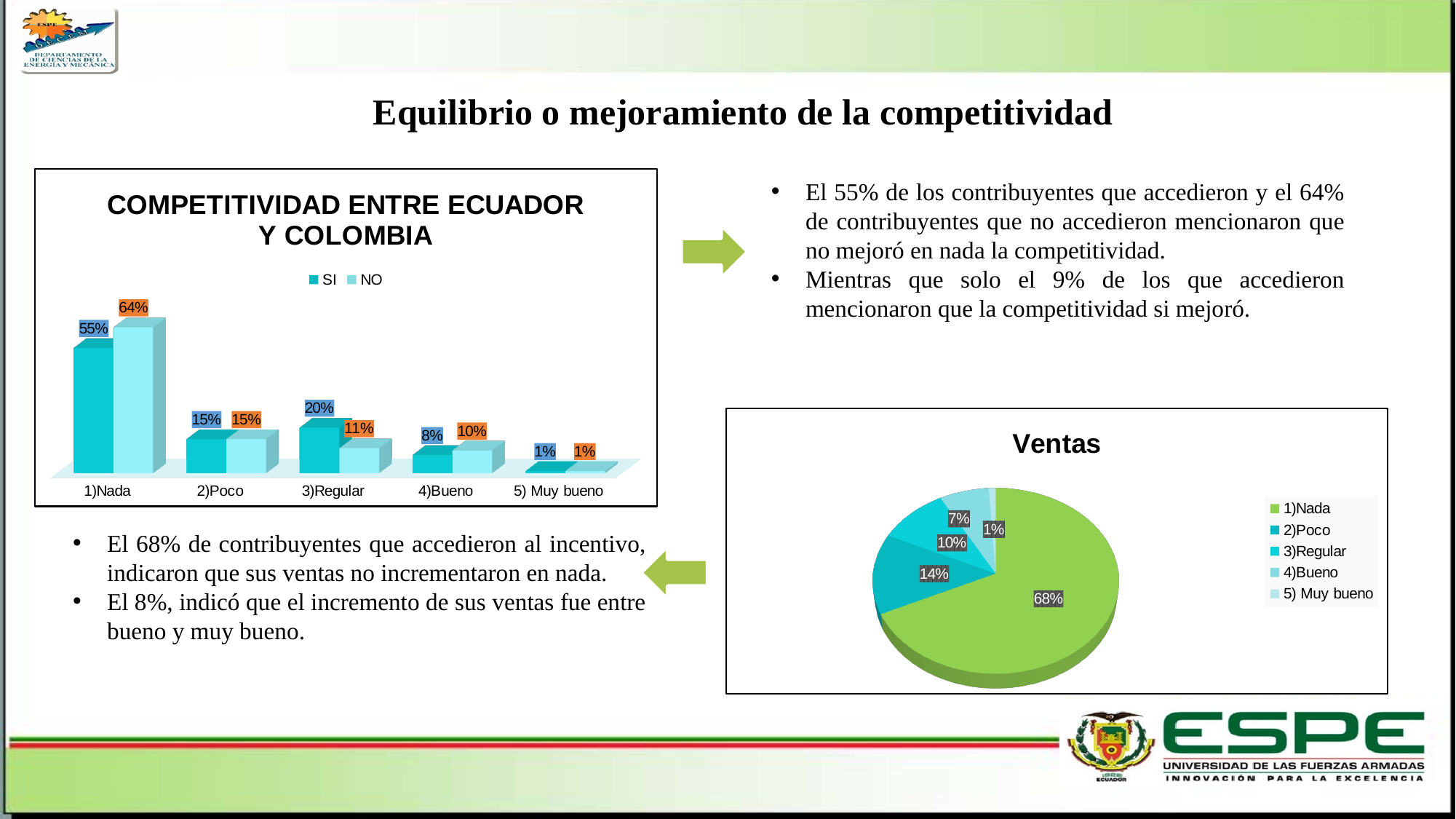
In the 'COMPETITIVIDAD ENTRE ECUADOR Y COLOMBIA' chart, which category has the highest NO value? 1)Nada What kind of chart is 'Ventas'? Pie chart In the 'COMPETITIVIDAD ENTRE ECUADOR Y COLOMBIA' chart, what is the NO value for 3)Regular? 11% In the 'COMPETITIVIDAD ENTRE ECUADOR Y COLOMBIA' chart, what is the difference between the NO and SI values for 1)Nada? 9% What kind of chart is 'COMPETITIVIDAD ENTRE ECUADOR Y COLOMBIA'? Bar chart In the 'COMPETITIVIDAD ENTRE ECUADOR Y COLOMBIA' chart, what is the SI value for 1)Nada? 55% In the 'Ventas' chart, what is the value for 4)Bueno? 7% In the 'COMPETITIVIDAD ENTRE ECUADOR Y COLOMBIA' chart, which is larger for 3)Regular, the SI value or the NO value? SI How many categories are shown on the x axis of the 'COMPETITIVIDAD ENTRE ECUADOR Y COLOMBIA' chart? 5 How many series does the legend of the 'COMPETITIVIDAD ENTRE ECUADOR Y COLOMBIA' chart list? 2 In the 'Ventas' chart, which category has the smallest slice? 5) Muy bueno In the 'Ventas' chart, what share does 1)Nada have? 68%